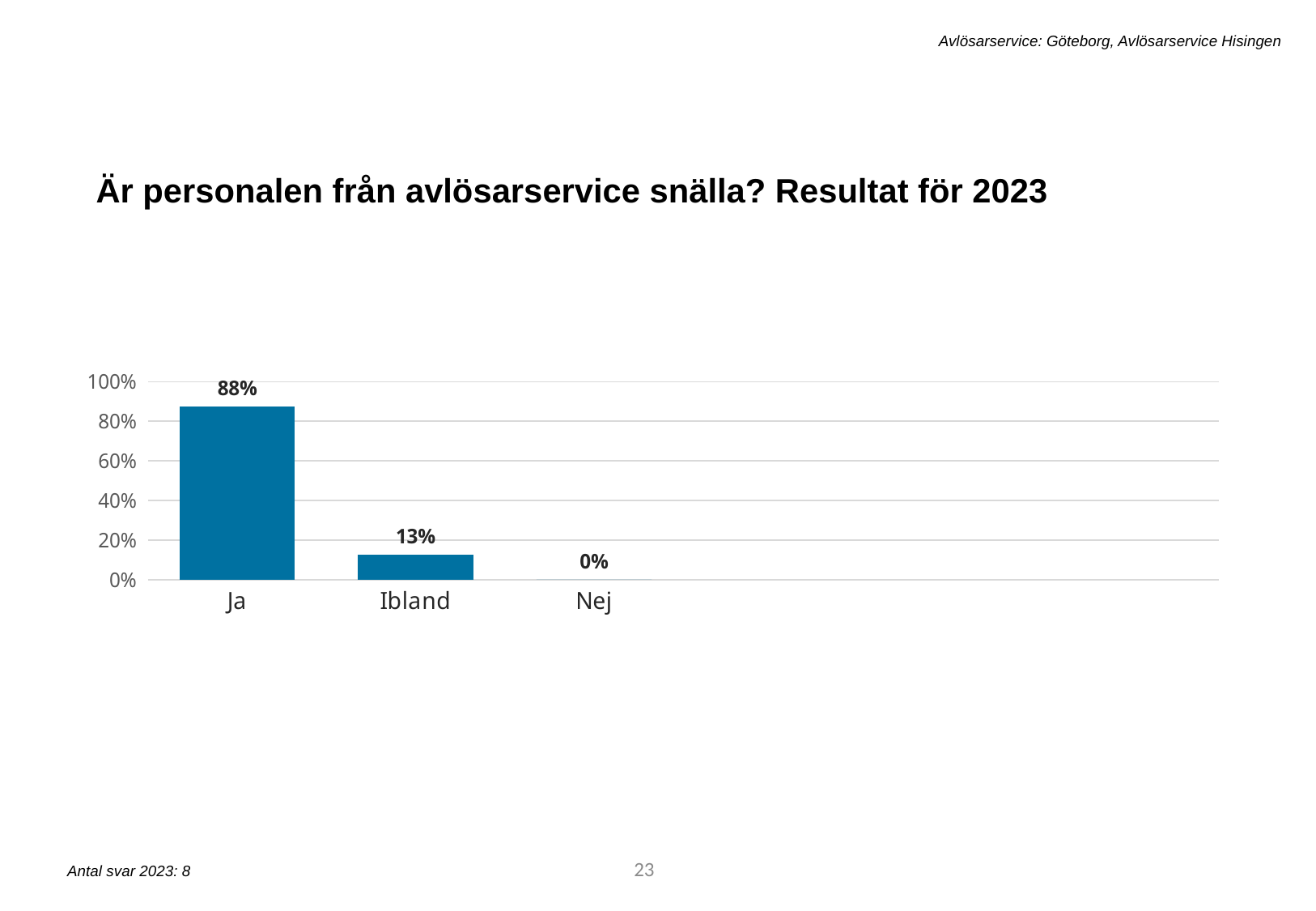
Which is larger, the value for Ibland or the value for Nej? Ibland Which category has the lowest value? Nej Which category has the highest value? Ja What is the value for Nej? 0% Is the value for Ibland greater or less than 20%? less What is the value for Ibland? 13% How many categories are shown on the x axis? 3 What is the value for Ja? 88% What is the difference between the values for Ja and Ibland? 75% What kind of chart is shown on the slide? bar chart Is the value for Ja greater or less than 80%? greater What is the title of the chart on the slide? Är personalen från avlösarservice snälla? Resultat för 2023